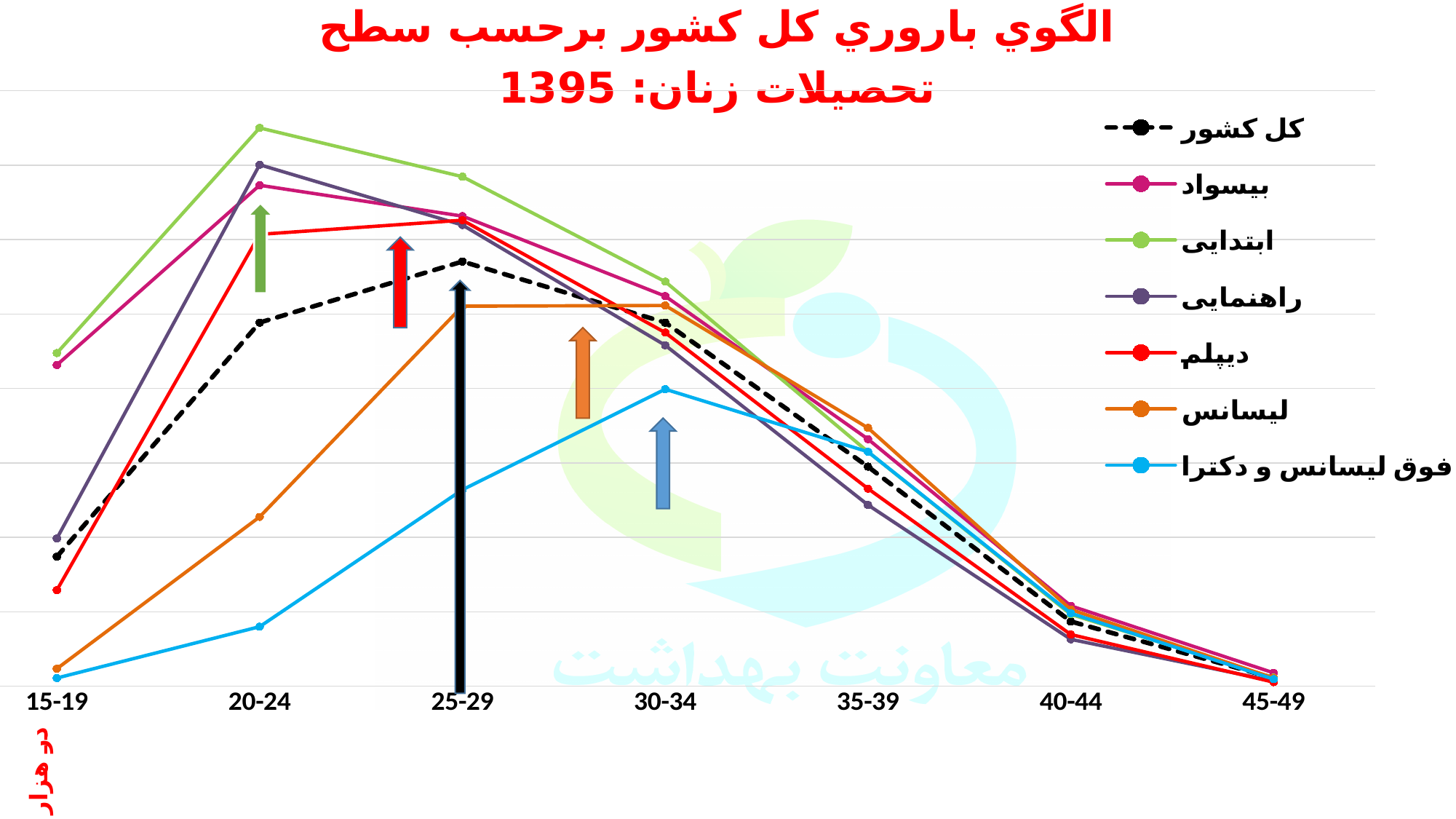
Which series has the lowest value in the 20-24 age group? فوق لیسانس و دکترا Which series is drawn with a dashed line? کل کشور In which age group does the ابتدایی series reach its highest value? 20-24 Which series reaches the highest point anywhere on the chart? ابتدایی In which age group does the فوق لیسانس و دکترا series reach its highest value? 30-34 How many series does the legend list? 7 Do the values of the کل کشور series rise or fall from 30-34 to 45-49? fall What kind of chart is shown on the slide? line chart How many age-group categories are shown on the x axis? 7 In the 15-19 age group, which is larger: بیسواد or دیپلم? بیسواد